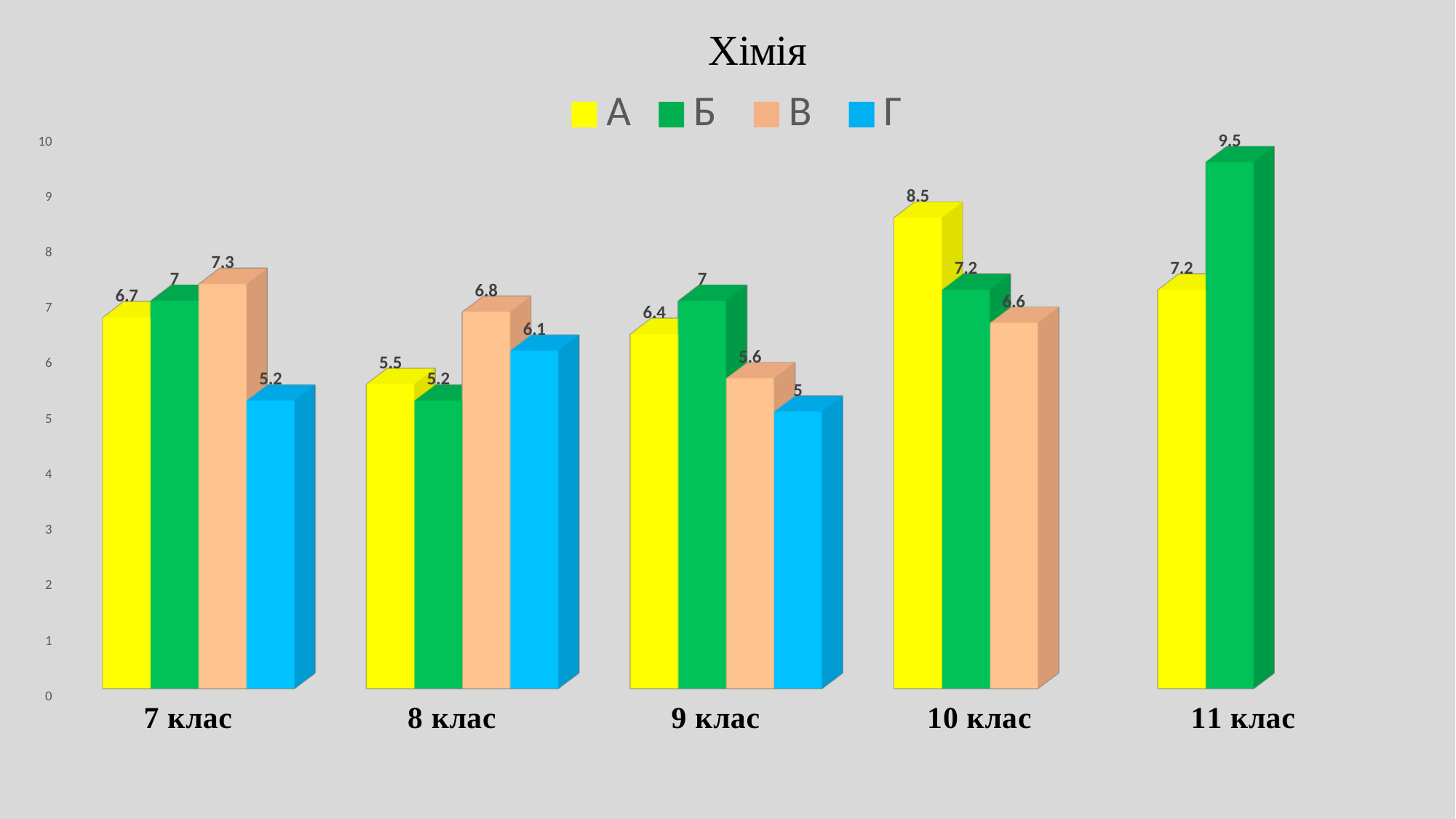
How many series does the legend list? 4 What is the difference between series А and series Б in 10 клас? 1.3 Which is larger in 8 клас: series А or series В? В Is the value for series Б in 11 клас greater or less than 9? greater What kind of chart is shown? bar chart Which series has the highest value in 11 клас? Б What is the value for series В in 10 клас? 6.6 What is the title of the chart? Хімія What is the value for series Г in 8 клас? 6.1 How many categories are shown on the x axis? 5 What is the value for series А in 7 клас? 6.7 Which series has the lowest value in 9 клас? Г